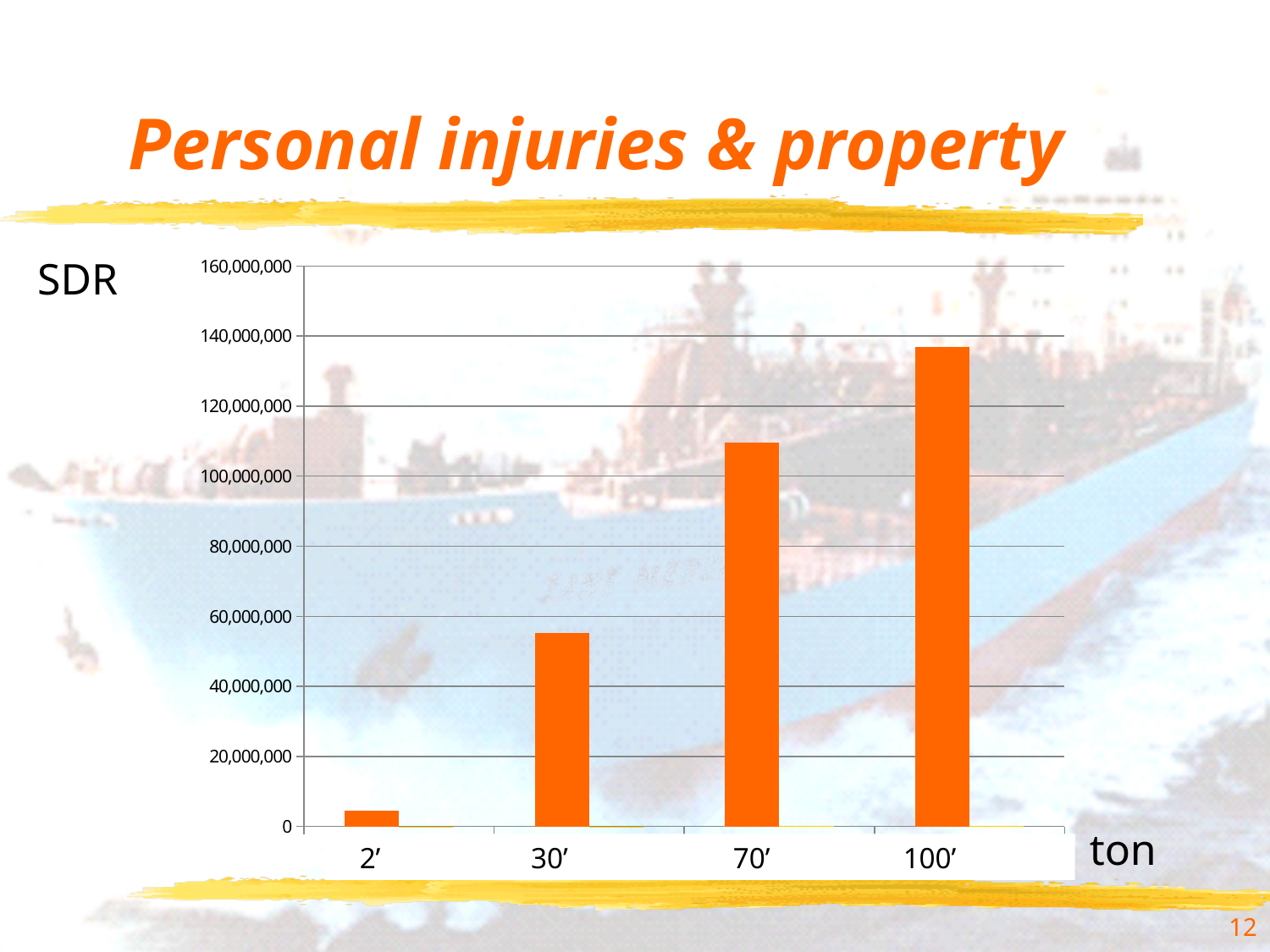
What unit label is shown next to the vertical axis of the chart? SDR Is the value for 100' greater or less than 120,000,000? greater Which is larger, the value for 30' or the value for 70'? 70' Is the value for 2' greater or less than 20,000,000? less What is the title of the slide containing the chart? Personal injuries & property Which category has the highest value? 100' How many categories are plotted on the x axis? 4 Do the values rise or fall from 2' to 100' along the x axis? rise What kind of chart is shown on the slide? bar chart Is the value for 70' greater or less than 100,000,000? greater Which category has the lowest value? 2'